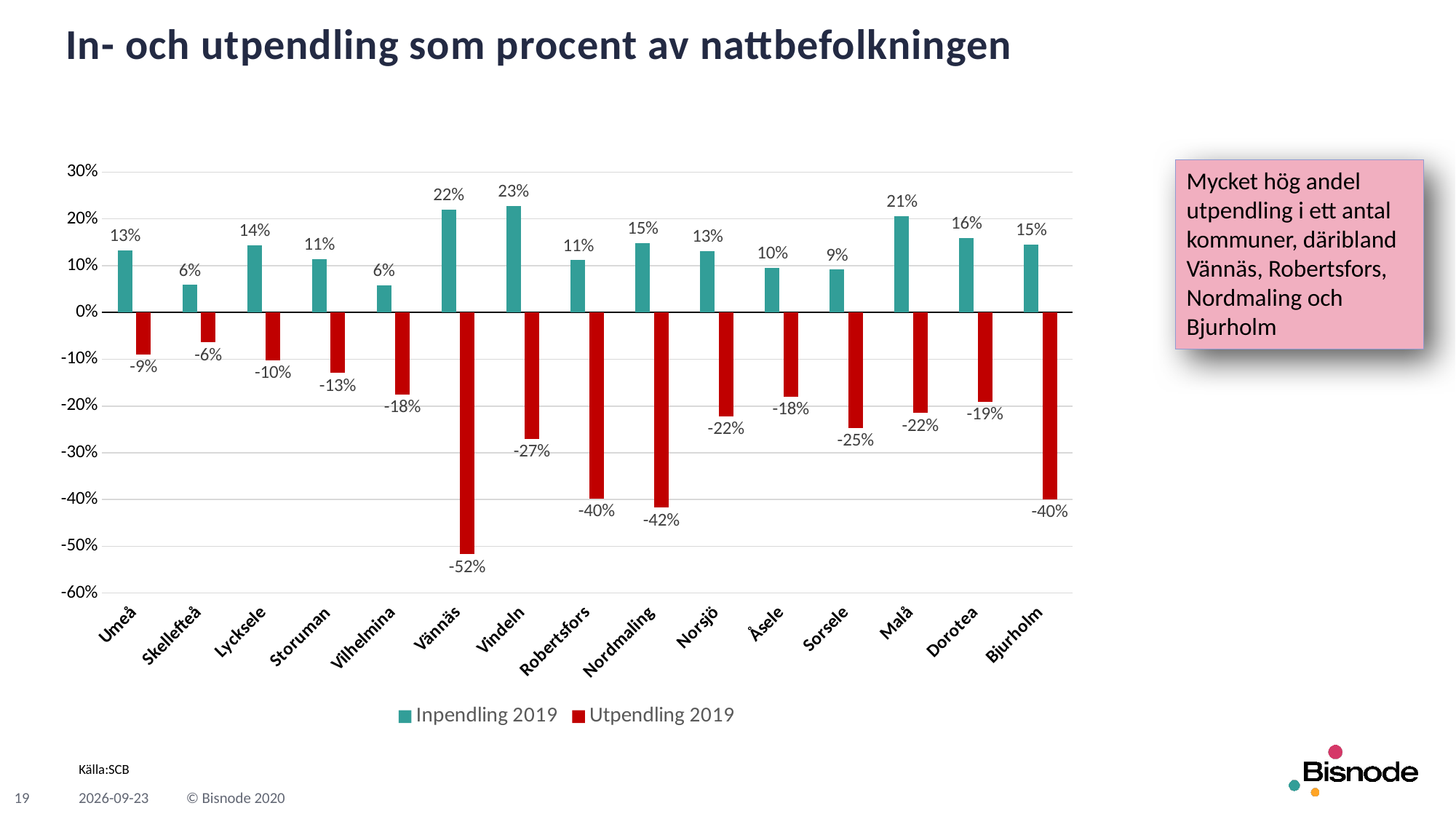
What is the Inpendling 2019 value for Vindeln? 23% What colour are the Utpendling 2019 bars? Red What is the Utpendling 2019 value for Nordmaling? -42% How many series does the legend list? 2 How many municipalities are shown on the x axis? 15 What is the Utpendling 2019 value for Vännäs? -52% Which municipality has the highest Inpendling 2019 value? Vindeln What kind of chart is shown on the slide? Bar chart Which has a larger Inpendling 2019 value, Dorotea or Storuman? Dorotea Which municipality has the lowest (most negative) Utpendling 2019 value? Vännäs What is the Inpendling 2019 value for Malå? 21% What is the difference between the Inpendling 2019 values for Vindeln and Umeå? 10 percentage points